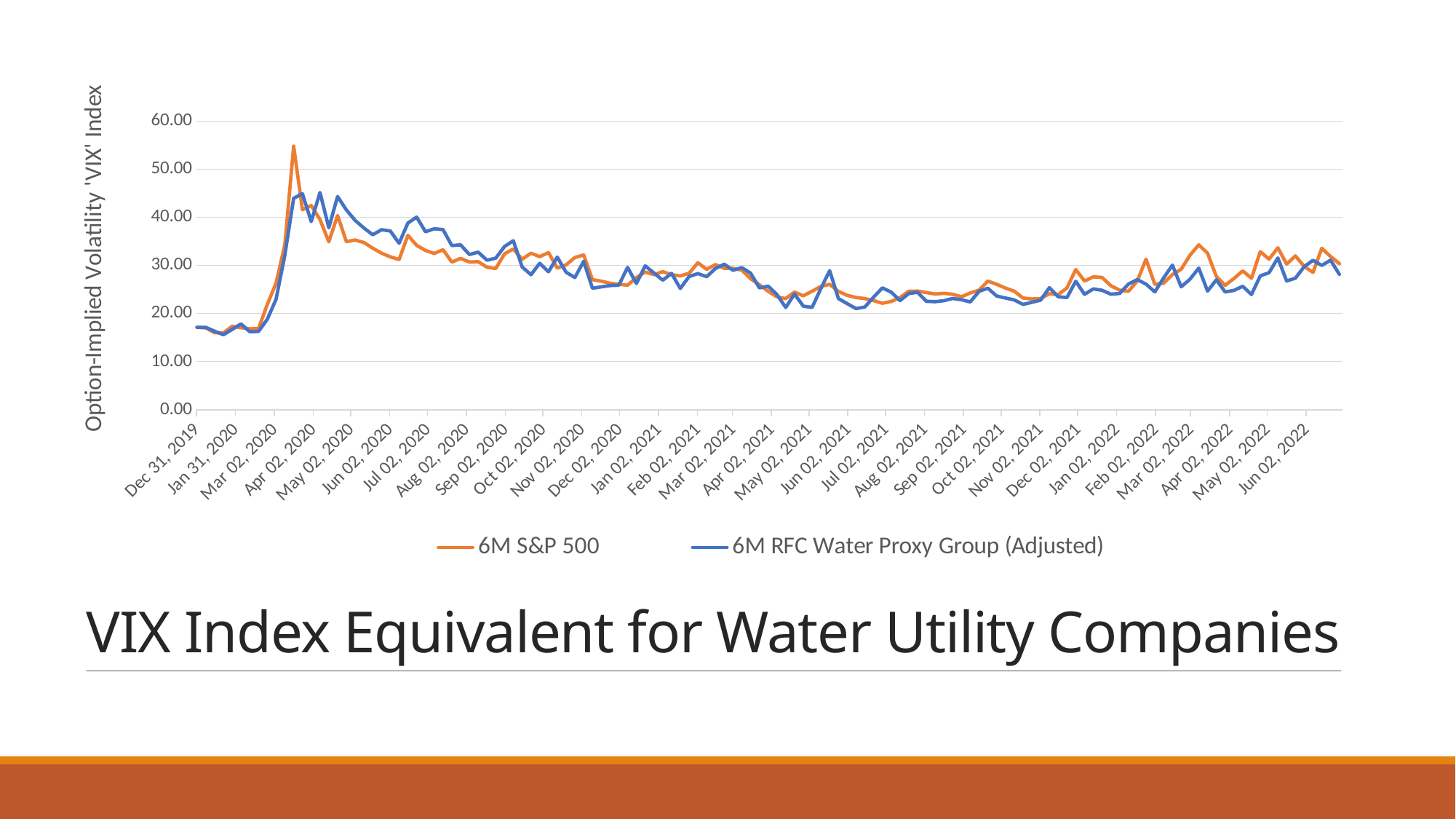
Is the value for 6M S&P 500 at Dec 31, 2019 greater or less than 20.00? less How many series does the legend list? 2 Between Dec 31, 2019 and Apr 02, 2020, do the values of both series rise or fall? rise Is the peak value of the 6M RFC Water Proxy Group (Adjusted) series greater or less than 50.00? less Is the value for 6M RFC Water Proxy Group (Adjusted) at Jun 02, 2021 greater or less than 30.00? less What is the title of the vertical axis? Option-Implied Volatility 'VIX' Index Which series reaches the higher peak around Apr 02, 2020? 6M S&P 500 From Apr 02, 2020 to Jul 02, 2021, do the values of the 6M S&P 500 series generally rise or fall? fall What kind of chart is shown on the slide? line chart What are the two series named in the legend? 6M S&P 500 and 6M RFC Water Proxy Group (Adjusted)